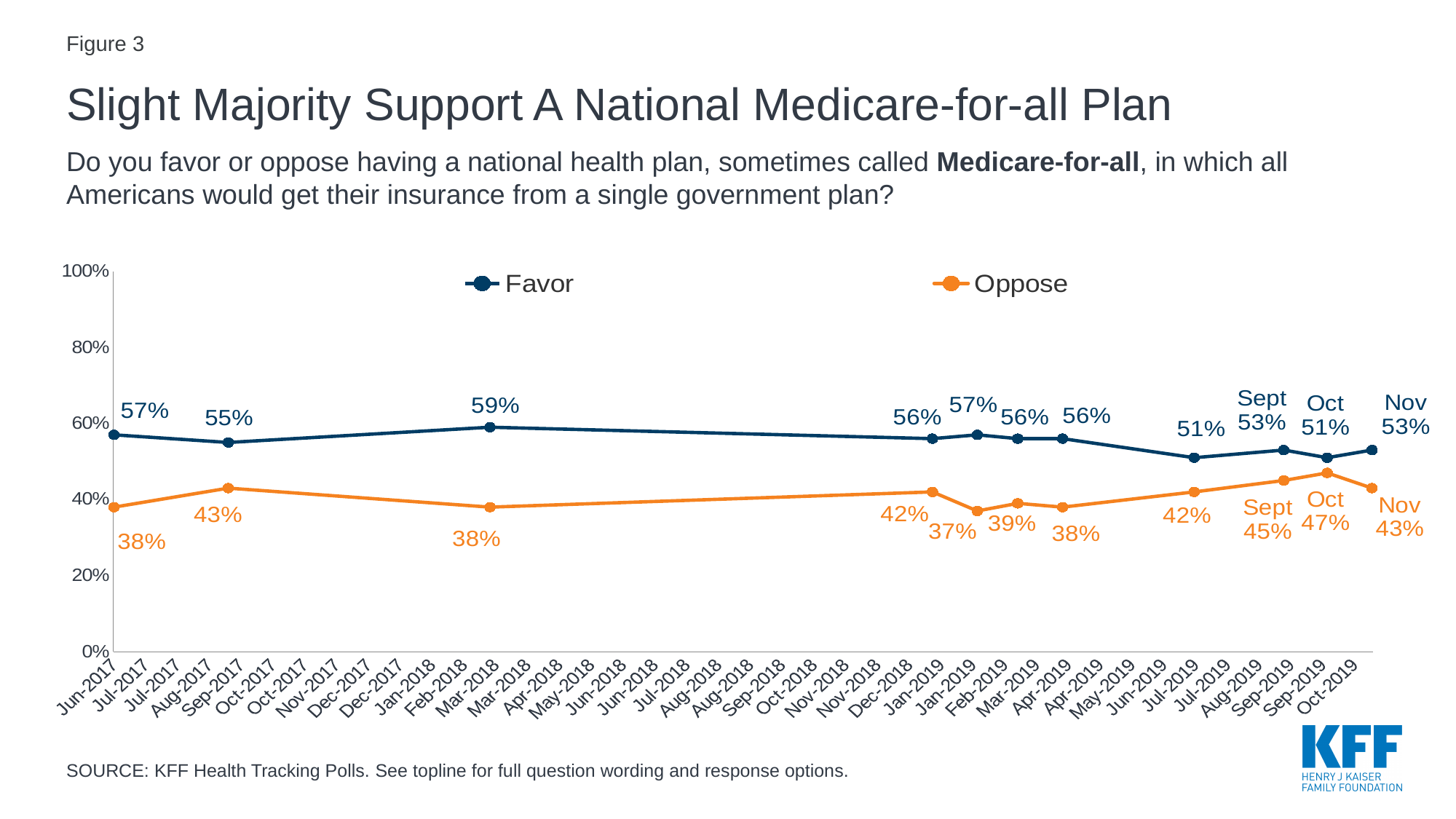
What are the two series named in the legend? Favor and Oppose What is the highest Favor value shown on the chart? 59% At the point labeled Sept, which is larger, Favor or Oppose? Favor What is the lowest Oppose value shown on the chart? 37% At the point labeled Nov, what is the difference between the Favor and Oppose values? 10 percentage points What is the Oppose value labeled Oct? 47% How many data points does each series have? 11 What type of chart is shown on the slide? Line chart How many series does the legend list? 2 What is the Favor value labeled Nov? 53% What is the highest Oppose value shown on the chart? 47% What is the first (leftmost) Favor value on the chart? 57%